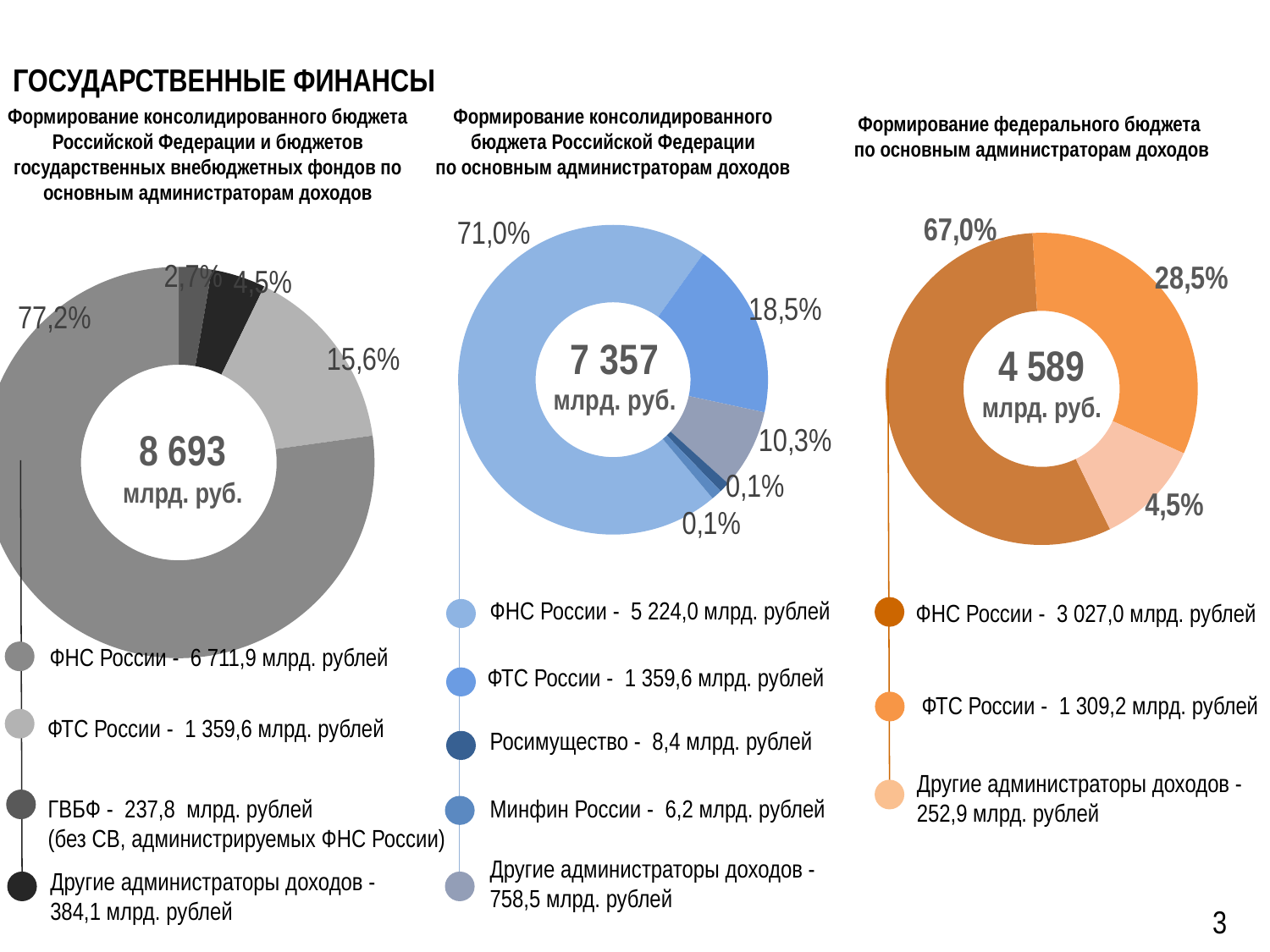
What total amount is shown in the centre of the right chart (federal budget by main revenue administrators)? 4 589 млрд. руб. In the right chart (federal budget by main revenue administrators), which is larger: the revenue of ФТС России or Другие администраторы доходов? ФТС России How many legend entries does the left chart (consolidated budget and state extra-budgetary funds) list? 4 In the middle chart (consolidated budget by main revenue administrators), what share is attributed to Другие администраторы доходов? 10,3% In the middle chart (consolidated budget by main revenue administrators), what is the difference between the revenue of Росимущество and Минфин России? 2,2 млрд. рублей In the left chart (consolidated budget and state extra-budgetary funds), what is the revenue amount for ФТС России? 1 359,6 млрд. рублей What type of chart is used for the three charts on the slide? Pie (donut) chart In the left chart (consolidated budget and state extra-budgetary funds), what share of revenue is attributed to ФНС России? 77,2% In the left chart (consolidated budget and state extra-budgetary funds), which administrator has the smallest share? ГВБФ In the middle chart (consolidated budget by main revenue administrators), which administrator has the largest share? ФНС России In the right chart (federal budget by main revenue administrators), what share is attributed to ФТС России? 28,5% In the middle chart (consolidated budget by main revenue administrators), what is the revenue amount for ФНС России? 5 224,0 млрд. рублей